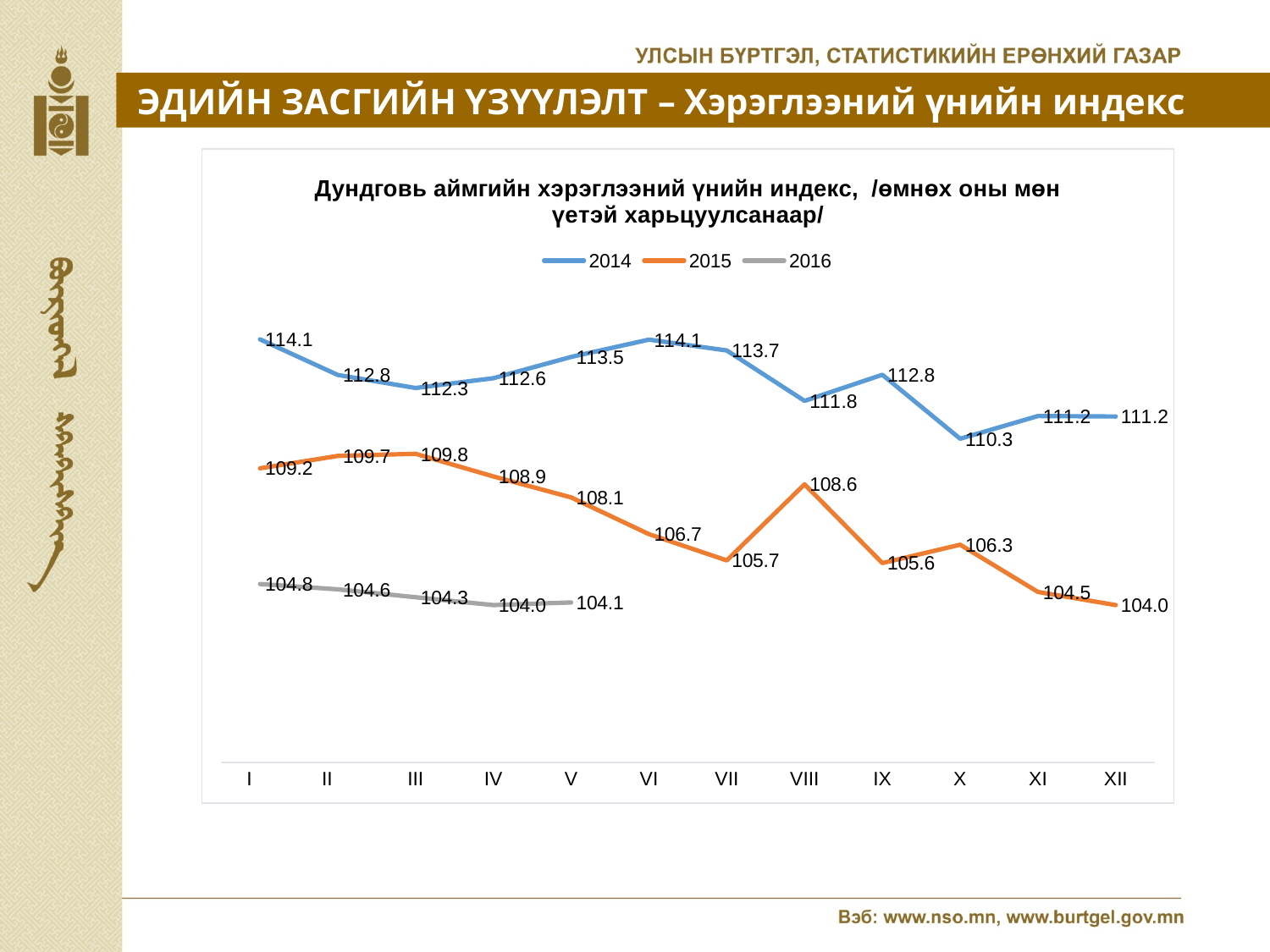
Which is larger, the 2015 value in month VII or the 2015 value in month VIII? VIII What is the value for 2014 in month I? 114.1 What is the difference between the 2015 values in month I and month XII? 5.2 How many series does the legend list? 3 How many months are shown on the x axis? 12 What kind of chart is shown on the slide? Line chart In which month does the 2014 series reach its lowest value? X Does the 2016 series rise or fall from month I to month V? Fall In which month does the 2015 series reach its highest value? III What is the value for 2016 in month IV? 104.0 What is the difference between the 2014 and 2015 values in month XII? 7.2 What is the value for 2015 in month VIII? 108.6